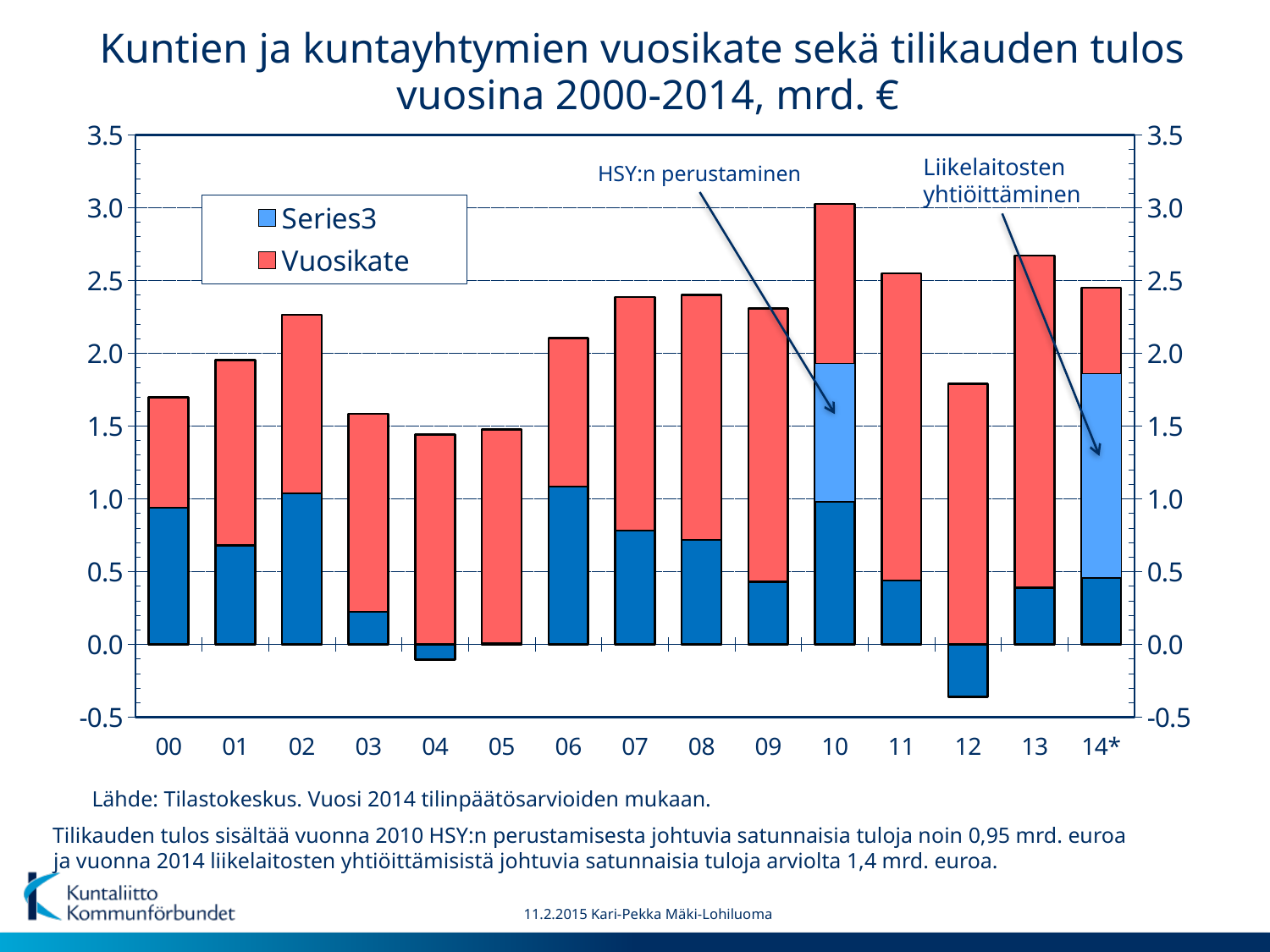
How many series does the legend list? 2 Which year has the tallest stacked bar overall? 10 What kind of chart is shown on the slide? bar chart Which stacked bar is taller overall, 10 or 13? 10 What are the two entries listed in the legend? Series3 and Vuosikate Which year has the lowest value for the dark blue bottom segment? 12 How many years (categories) are shown on the x axis? 15 Is the total height of the bar for 02 greater or less than 2.0? greater Is the total height of the bar for 12 greater or less than 2.0? less Is the total height of the bar for 10 greater or less than 2.5? greater Which stacked bar is taller overall, 11 or 12? 11 Do the total bar heights rise or fall from 04 to 08? rise